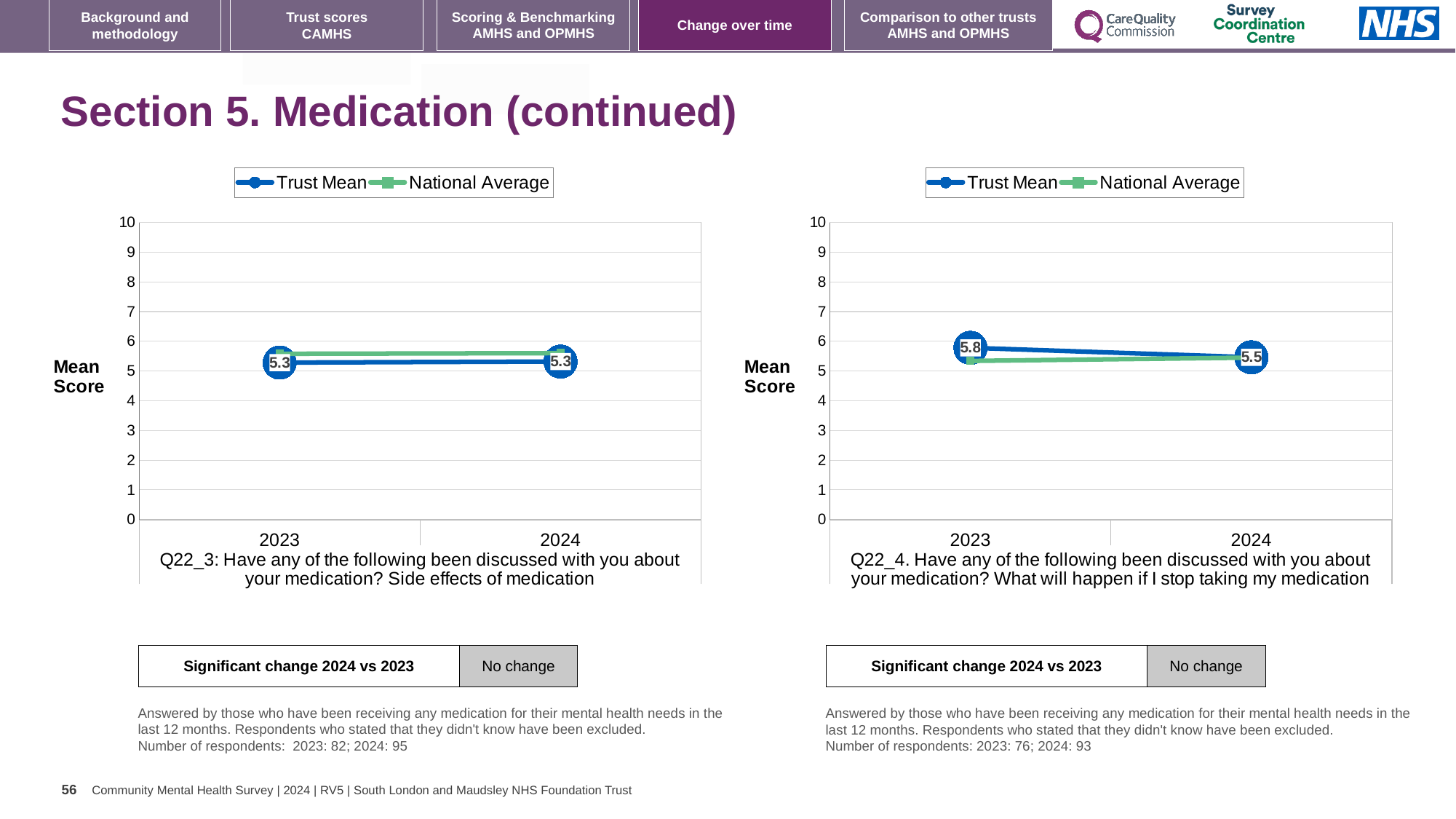
How many series does the legend of the Q22_4 chart on the right list? 2 In the Q22_4 chart on the right, what is the Trust Mean for 2023? 5.8 In the Q22_3 chart on the left, is the National Average for 2024 greater or less than 7? less In the Q22_3 chart on the left, what is the Trust Mean for 2023? 5.3 In the Q22_4 chart on the right, what is the Trust Mean for 2024? 5.5 In the Q22_4 chart on the right, by how much did the Trust Mean change from 2023 to 2024? 0.3 In the Q22_4 chart on the right, does the Trust Mean rise or fall from 2023 to 2024? fall How many years are shown on the x axis of the Q22_3 chart on the left? 2 In the Q22_4 chart on the right, which year has the higher Trust Mean, 2023 or 2024? 2023 In the Q22_3 chart on the left, what is the Trust Mean for 2024? 5.3 What kind of chart is the Q22_3 chart on the left? line chart In the Q22_3 chart on the left, does the Trust Mean rise, fall or stay the same from 2023 to 2024? stays the same